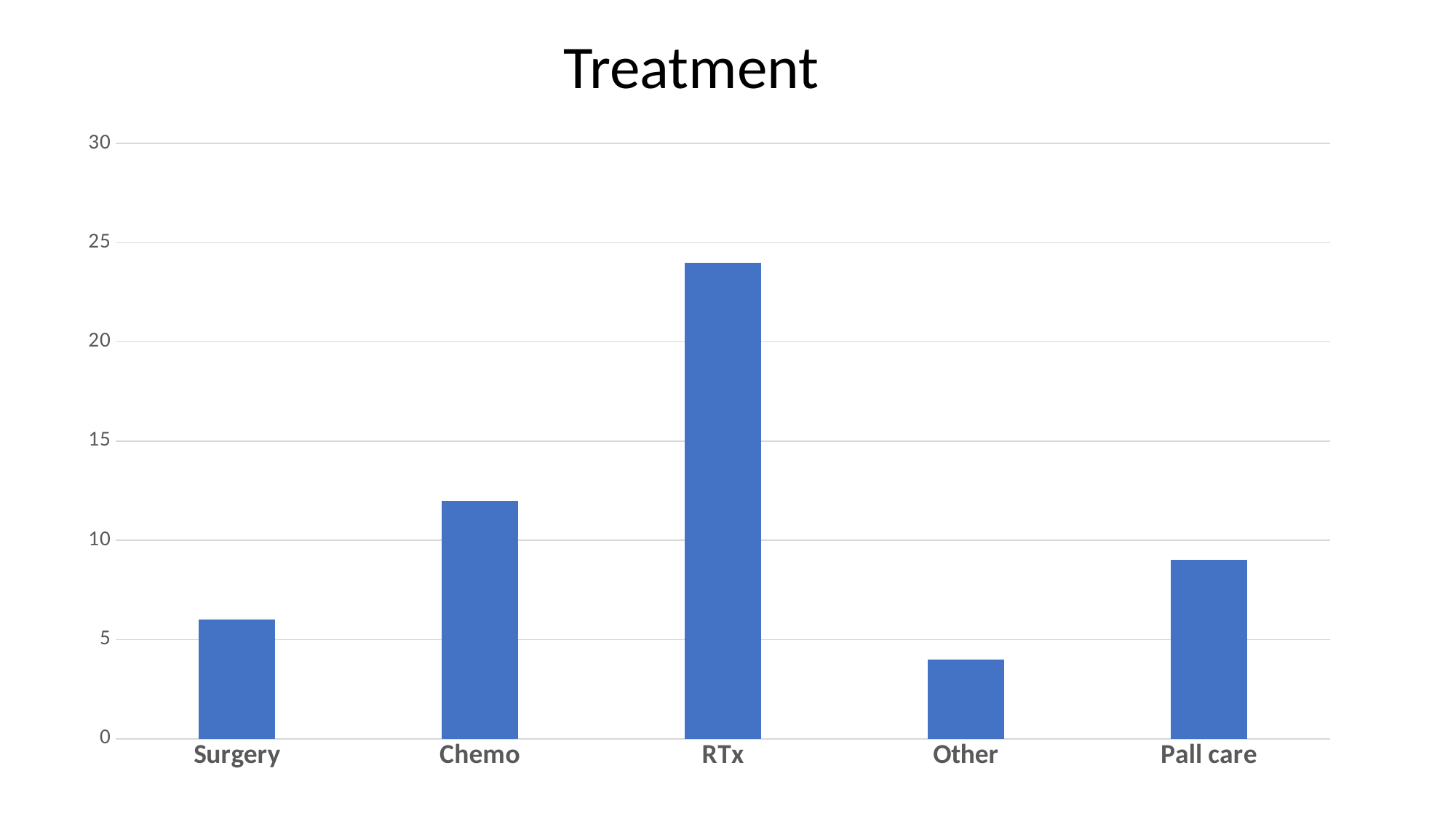
Is the value for RTx greater or less than 20? greater What kind of chart is shown on the slide? bar chart Is the value for Other greater or less than 5? less Which is larger, the value for Chemo or the value for Pall care? Chemo Is the value for Chemo greater or less than 10? greater Which treatment category has the lowest bar? Other What is the title of the chart? Treatment How many treatment categories are shown on the x axis? 5 Which is larger, the value for Surgery or the value for Other? Surgery Which treatment category has the highest bar? RTx